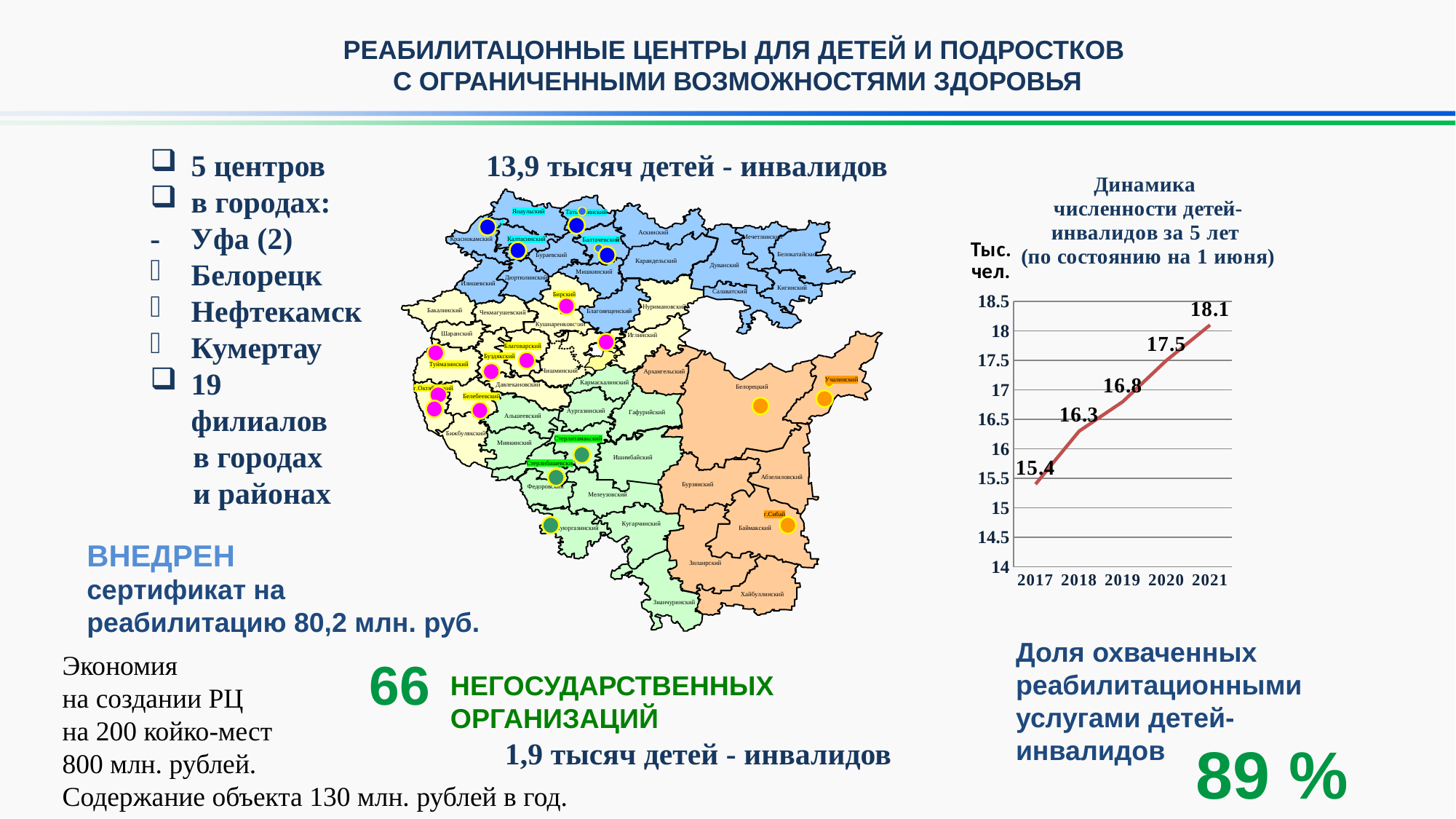
Which is larger in the line chart, the value for 2018 or the value for 2020? 2020 How many years (data points) are plotted in the line chart? 5 Do the values in the line chart rise or fall from 2017 to 2021? rise Which year has the lowest value in the line chart? 2017 What is the difference between the 2020 and 2018 values in the line chart? 1.2 What is the value for 2017 in the line chart? 15.4 What is the difference between the 2021 and 2017 values in the line chart? 2.7 Which year has the highest value in the line chart? 2021 What is the value for 2019 in the line chart? 16.8 What is the value for 2021 in the line chart? 18.1 What type of chart is used to show the dynamics of the number of children with disabilities over 5 years? line chart What unit is shown on the vertical axis of the line chart? Тыс. чел.